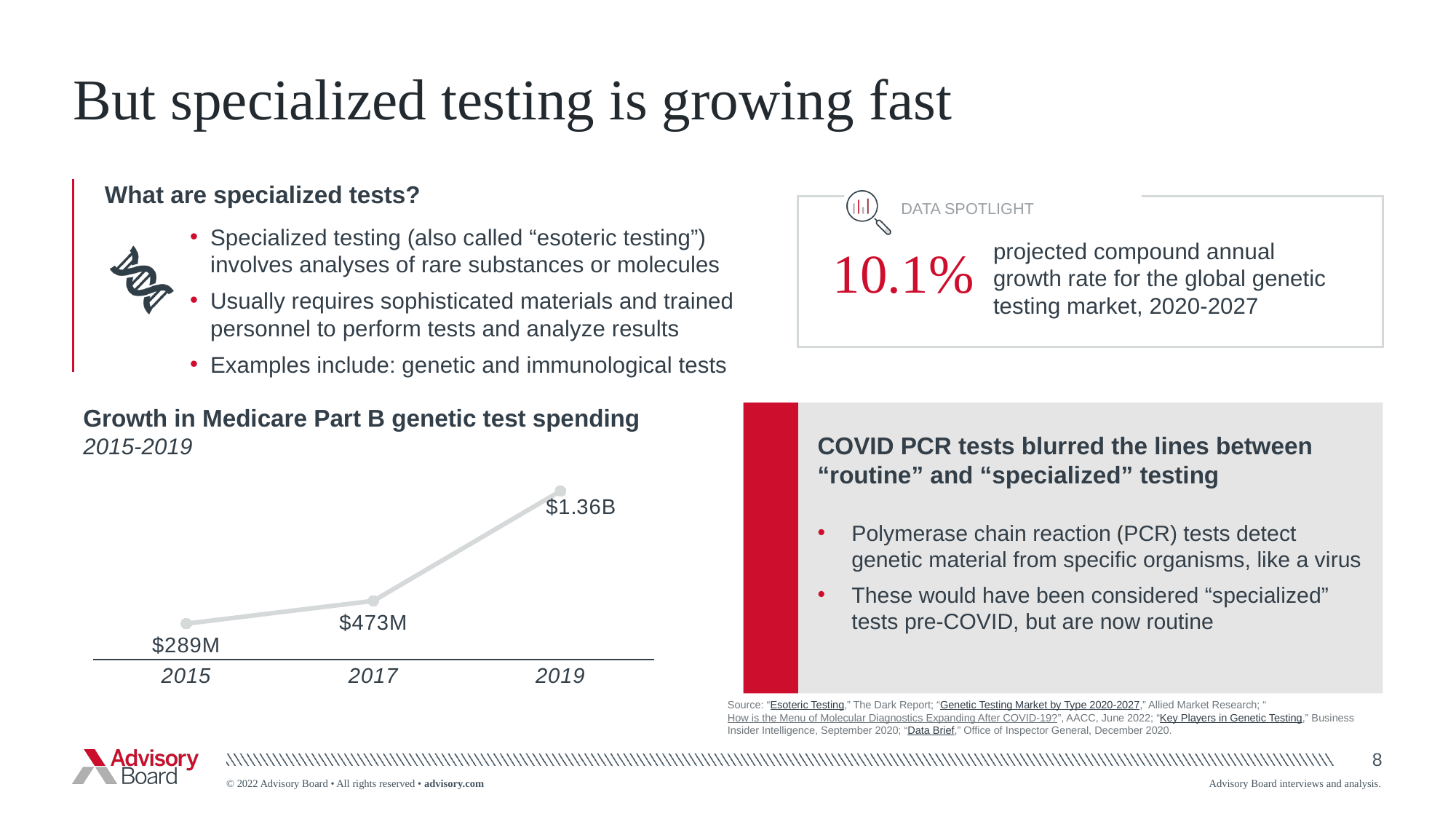
What time period does the Medicare Part B genetic test spending chart cover? 2015-2019 What was Medicare Part B genetic test spending in 2019? $1.36B How much did Medicare Part B genetic test spending increase from 2015 to 2017? $184M Which year shows the lowest Medicare Part B genetic test spending? 2015 How many data points are plotted on the Medicare Part B genetic test spending chart? 3 Does Medicare Part B genetic test spending rise or fall from 2015 to 2019? rise Which year had higher Medicare Part B genetic test spending, 2017 or 2019? 2019 What is the title of the line chart on the slide? Growth in Medicare Part B genetic test spending What type of chart is used to show growth in Medicare Part B genetic test spending? line chart Which year shows the highest Medicare Part B genetic test spending? 2019 What was Medicare Part B genetic test spending in 2017? $473M What was Medicare Part B genetic test spending in 2015? $289M